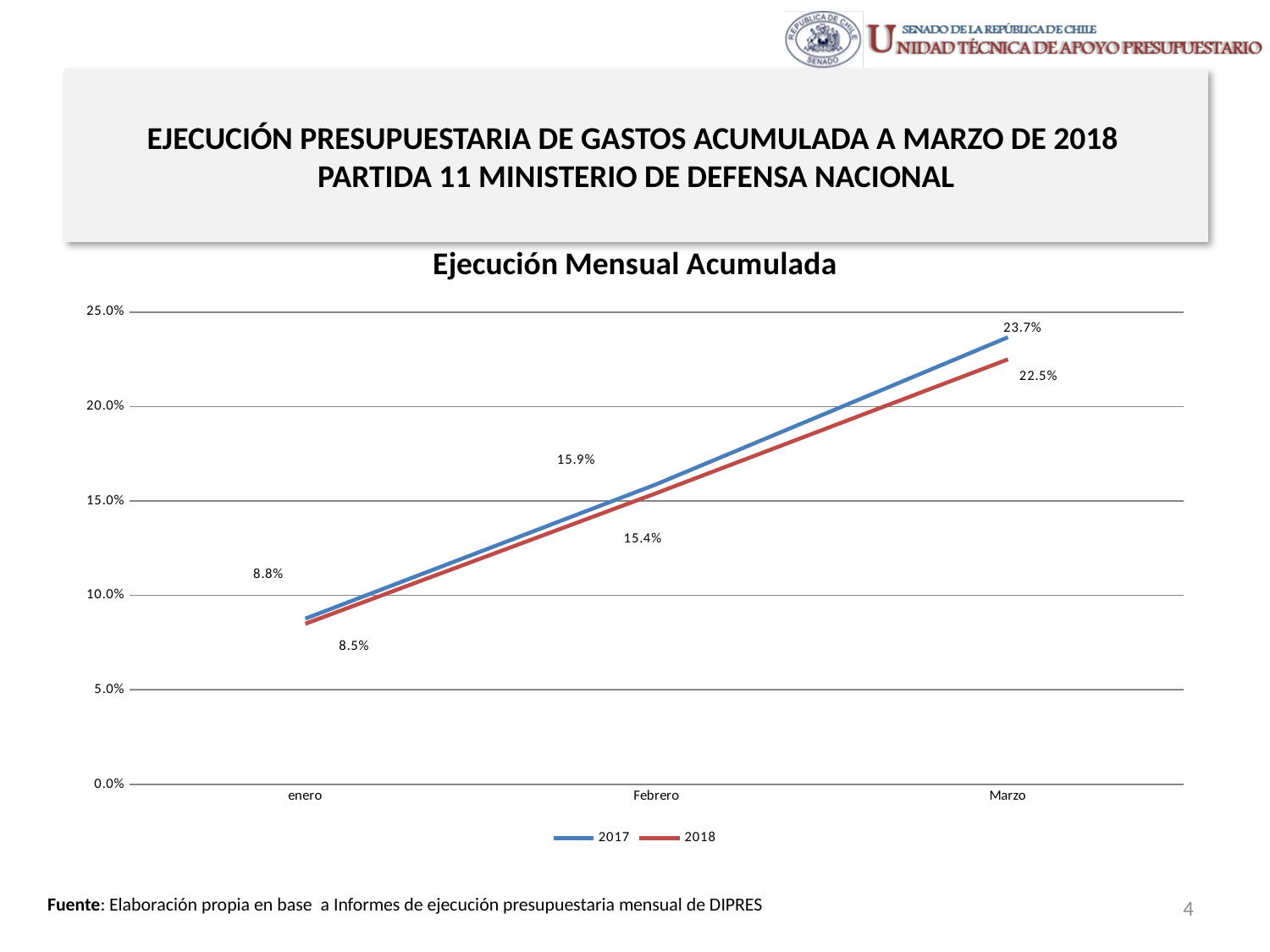
Do the values for 2017 rise or fall from enero to Marzo? rise In which month is the 2018 series highest? Marzo What is the value for 2017 in enero? 8.8% What is the difference between the 2017 and 2018 values in Marzo? 1.2% What type of chart is shown under the title "Ejecución Mensual Acumulada"? line chart Which series has the larger value in Febrero, 2017 or 2018? 2017 What is the value for 2018 in Febrero? 15.4% What is the value for 2017 in Marzo? 23.7% What is the value for 2018 in enero? 8.5% How many series does the legend list? 2 How many months are shown on the x axis? 3 In which month is the 2017 series lowest? enero